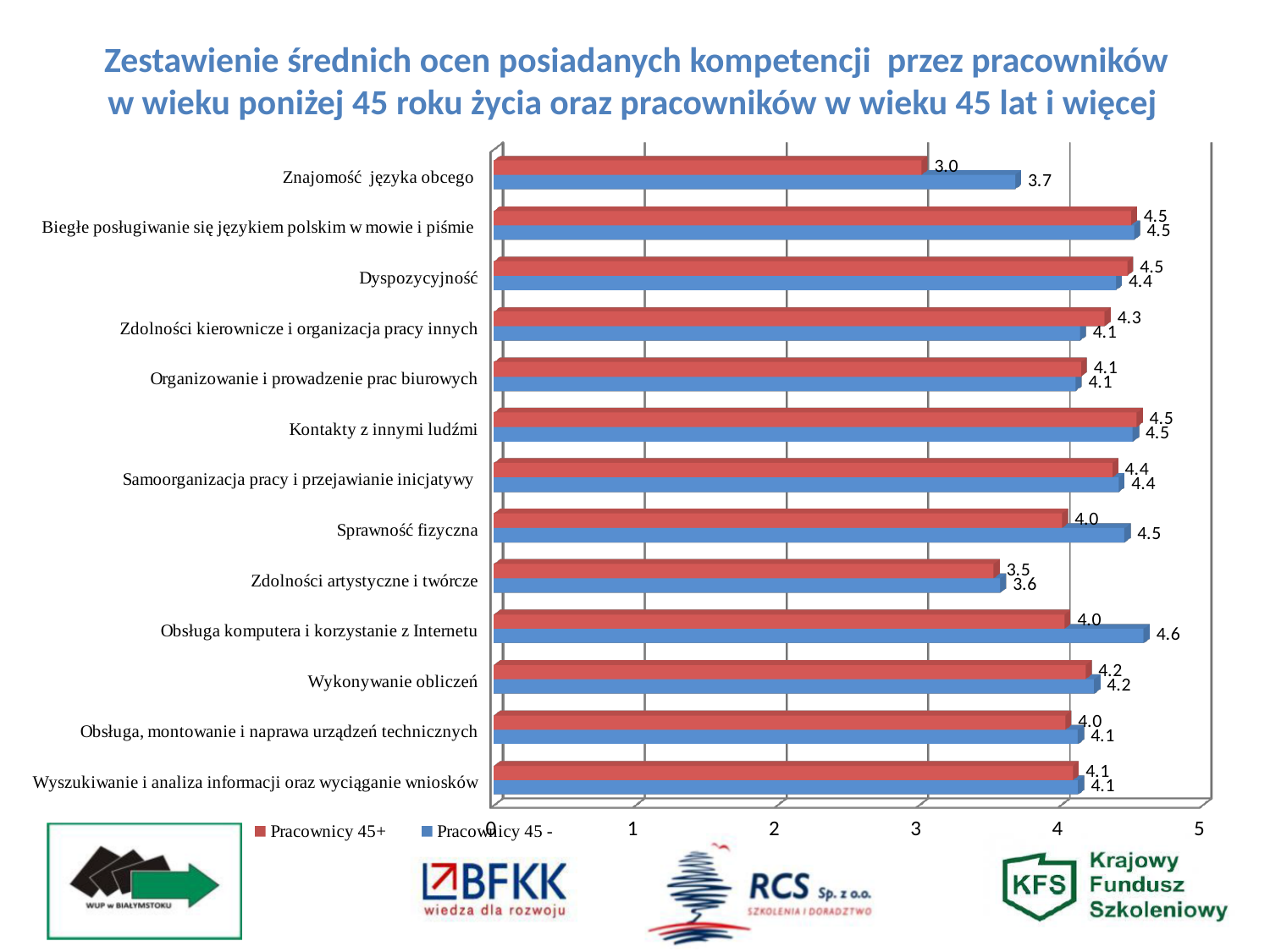
Which category has the highest value for Pracownicy 45 -? Obsługa komputera i korzystanie z Internetu How many categories are shown on the chart? 13 What is the difference between Pracownicy 45 - and Pracownicy 45+ for Obsługa komputera i korzystanie z Internetu? 0.6 What kind of chart is shown on the slide? Bar chart What is the value for Pracownicy 45 - for Obsługa komputera i korzystanie z Internetu? 4.6 What is the difference between Pracownicy 45 - and Pracownicy 45+ for Znajomość języka obcego? 0.7 What is the value for Pracownicy 45+ for Znajomość języka obcego? 3.0 What is the value for Pracownicy 45 - for Sprawność fizyczna? 4.5 What is the value for Pracownicy 45+ for Zdolności artystyczne i twórcze? 3.5 For Sprawność fizyczna, which series has the larger value, Pracownicy 45+ or Pracownicy 45 -? Pracownicy 45 - Which category has the lowest value for Pracownicy 45+? Znajomość języka obcego How many series does the legend list? 2